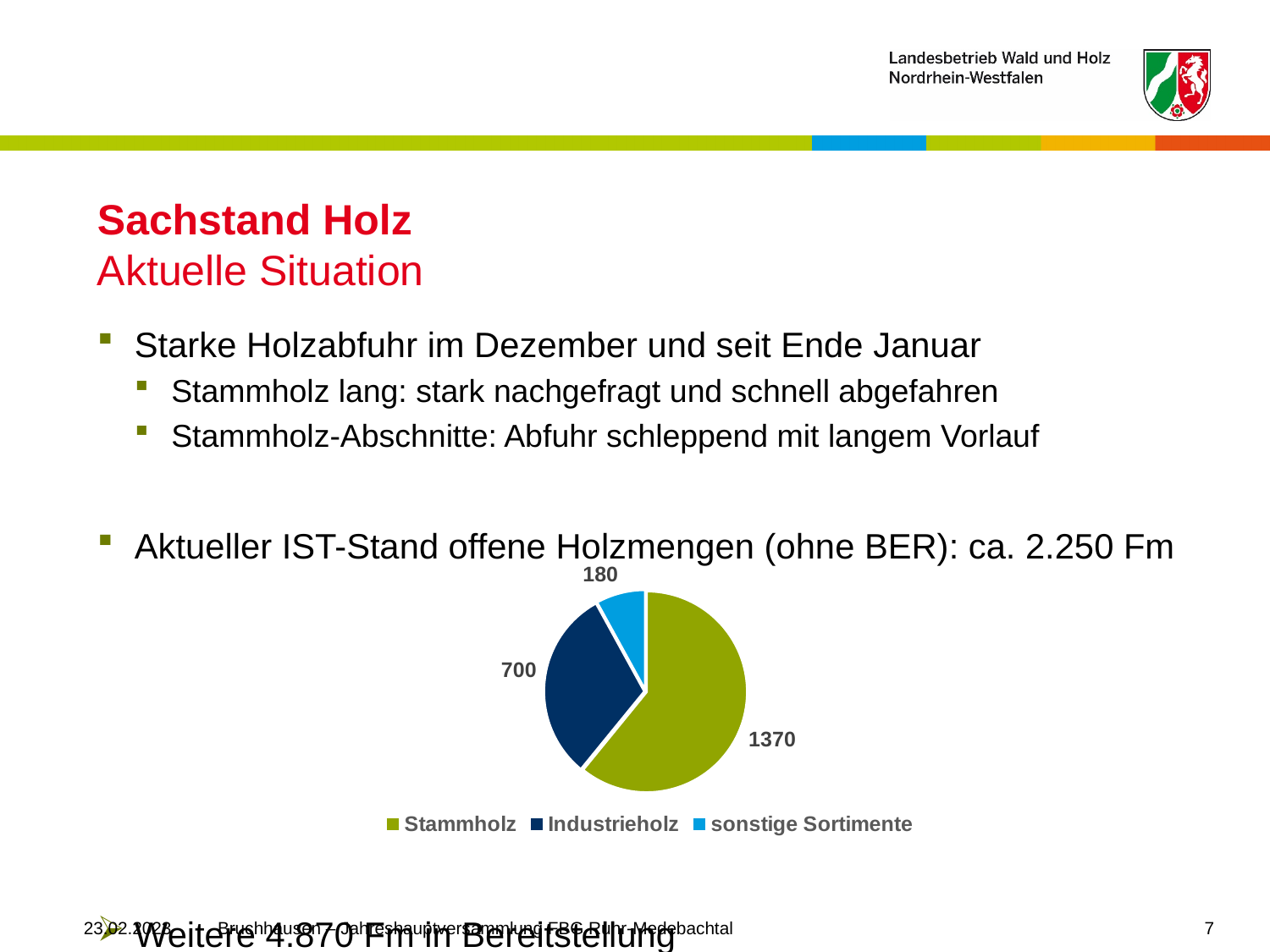
How many slices does the pie chart have? 3 What type of chart is shown on the slide? pie chart What is the value for Stammholz in the pie chart? 1370 What is the difference between the values for Industrieholz and sonstige Sortimente? 520 Which category has the smallest slice in the pie chart? sonstige Sortimente Which is larger, the value for Industrieholz or the value for sonstige Sortimente? Industrieholz Which category has the largest slice in the pie chart? Stammholz What share of the pie does sonstige Sortimente represent? 8% What is the value for sonstige Sortimente in the pie chart? 180 What is the value for Industrieholz in the pie chart? 700 What is the difference between the values for Stammholz and Industrieholz? 670 What is the total of all slices in the pie chart? 2250